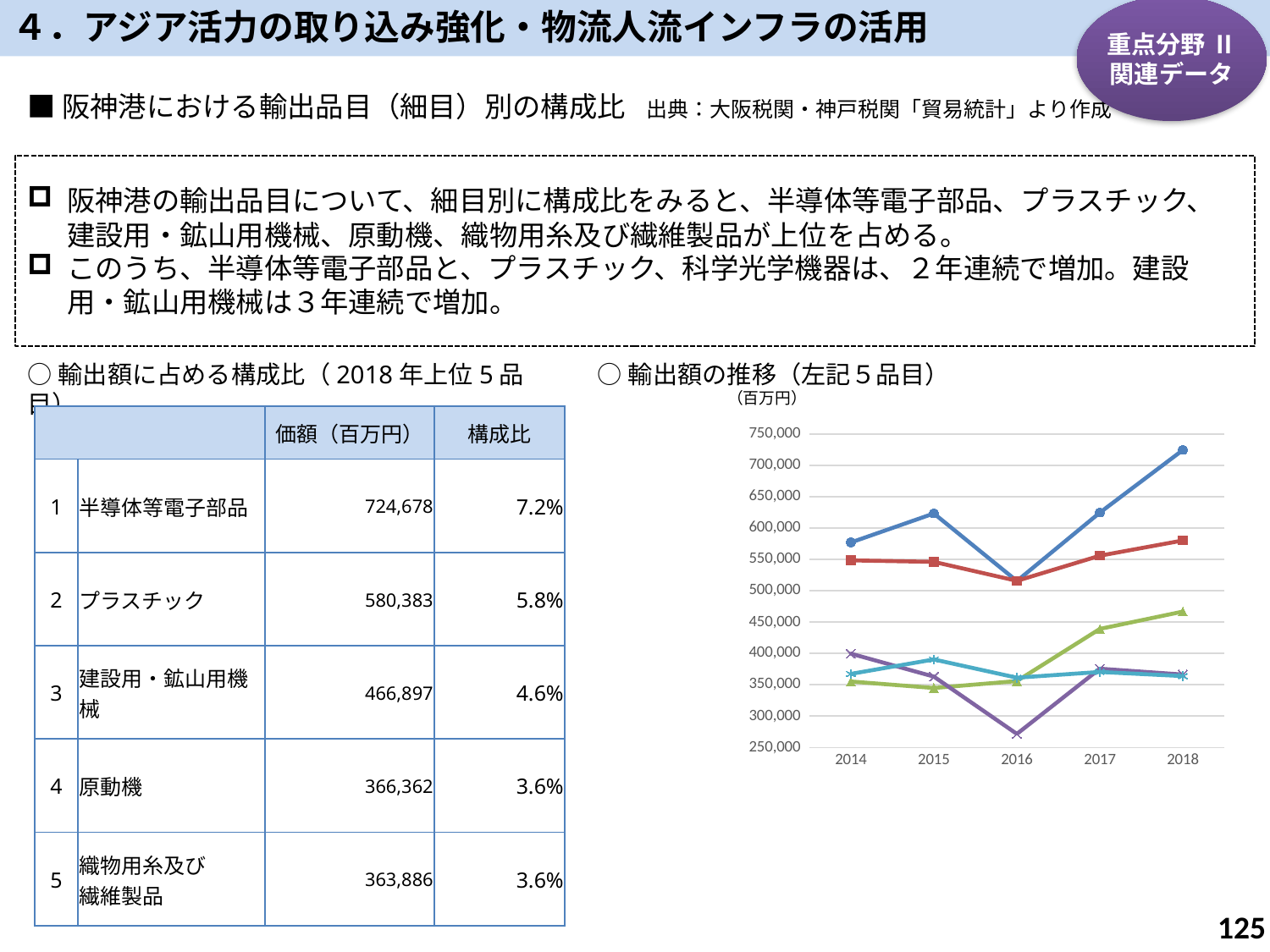
What kind of chart is shown on the right side of the slide? line chart In the line chart, is the value of the blue line in 2018 greater or less than 700,000? greater What unit is shown above the y axis of the line chart? 百万円 How many years are shown on the x axis of the line chart? 5 In the line chart, which is larger in 2018, the blue line or the red line? the blue line In the line chart, in which year does the blue line reach its highest value? 2018 In the line chart, is the value of the purple line in 2016 greater or less than 300,000? less In the line chart, does the blue line rise or fall from 2016 to 2018? rise In the line chart, in which year does the purple line reach its lowest value? 2016 In the line chart, is the value of the blue line in 2016 greater or less than 550,000? less How many lines are plotted in the line chart? 5